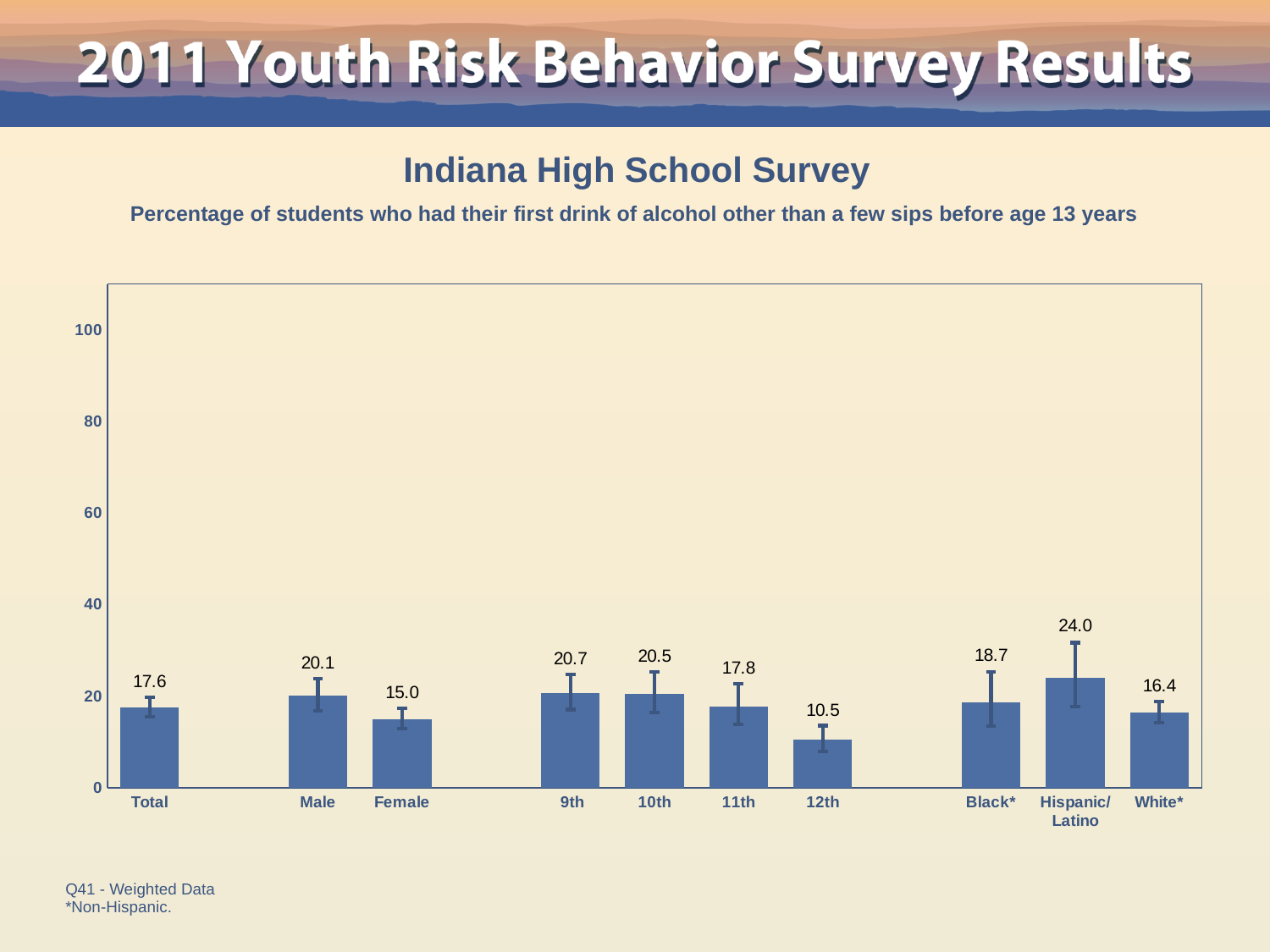
What is the value for Hispanic/Latino? 24.0 What is the difference between the values for Male and Female? 5.1 What kind of chart is this? bar chart Is the value for 9th greater or less than 20? greater What is the value for Female? 15.0 What is the value for 12th? 10.5 How many categories are shown on the x axis? 10 Which is larger, the value for Black* or the value for White*? Black* Which category has the lowest value? 12th What is the value for Total? 17.6 Which category has the highest value? Hispanic/Latino Do the values rise or fall from 9th to 12th grade? fall